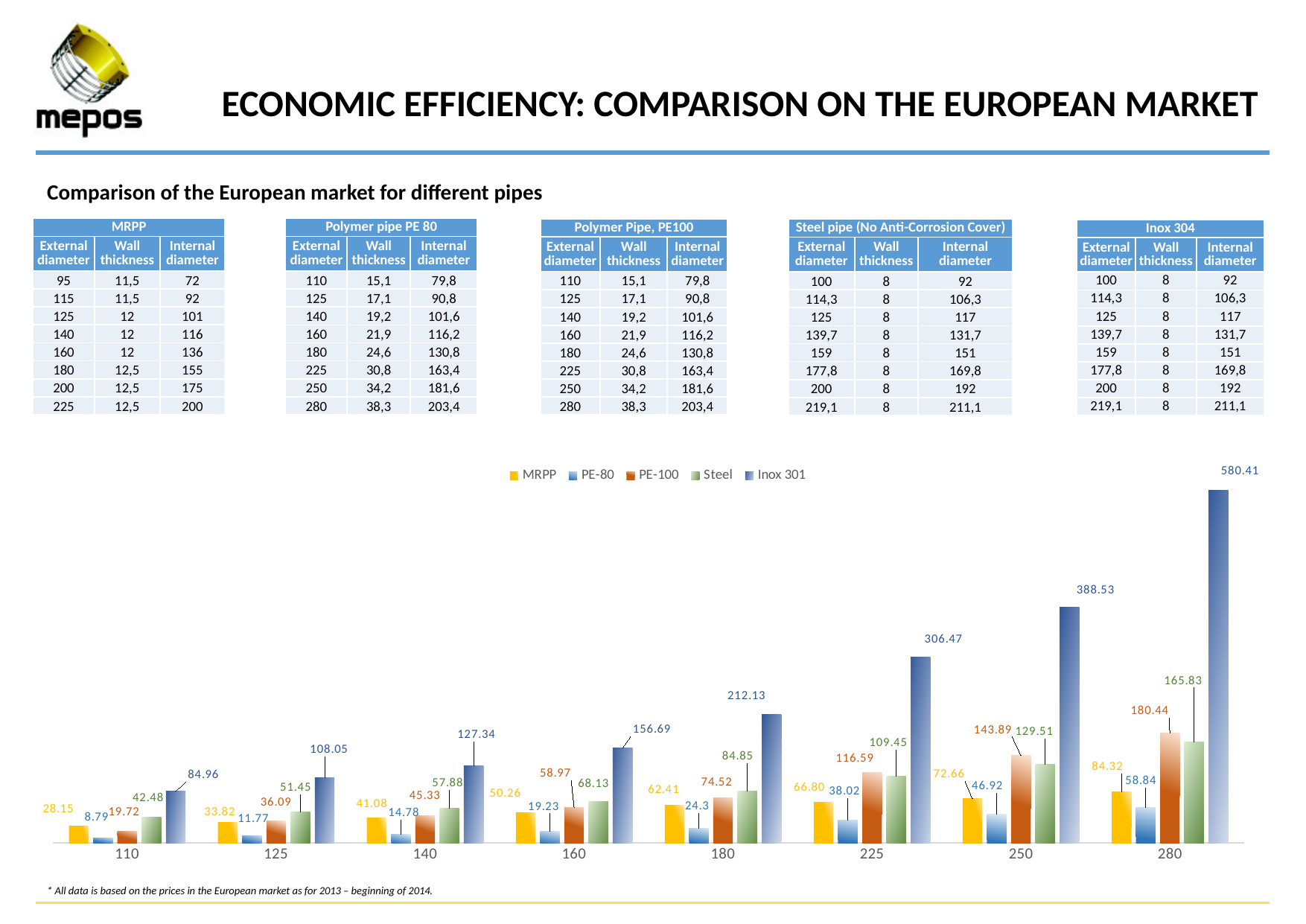
What is the value for Steel at category 225? 109.45 What is the value for Inox 301 at category 280? 580.41 Which category has the highest Inox 301 value? 280 At category 250, which is larger: PE-100 or Steel? PE-100 Do the Inox 301 values rise or fall as the categories increase from 110 to 280? Rise What kind of chart is shown on the slide? Bar chart What is the difference between the Inox 301 value and the MRPP value at category 280? 496.09 Which series has the lowest value at category 110? PE-80 How many series does the chart legend list? 5 How many categories are shown on the x axis of the chart? 8 What is the value for PE-80 at category 180? 24.3 What is the value for MRPP at category 110? 28.15